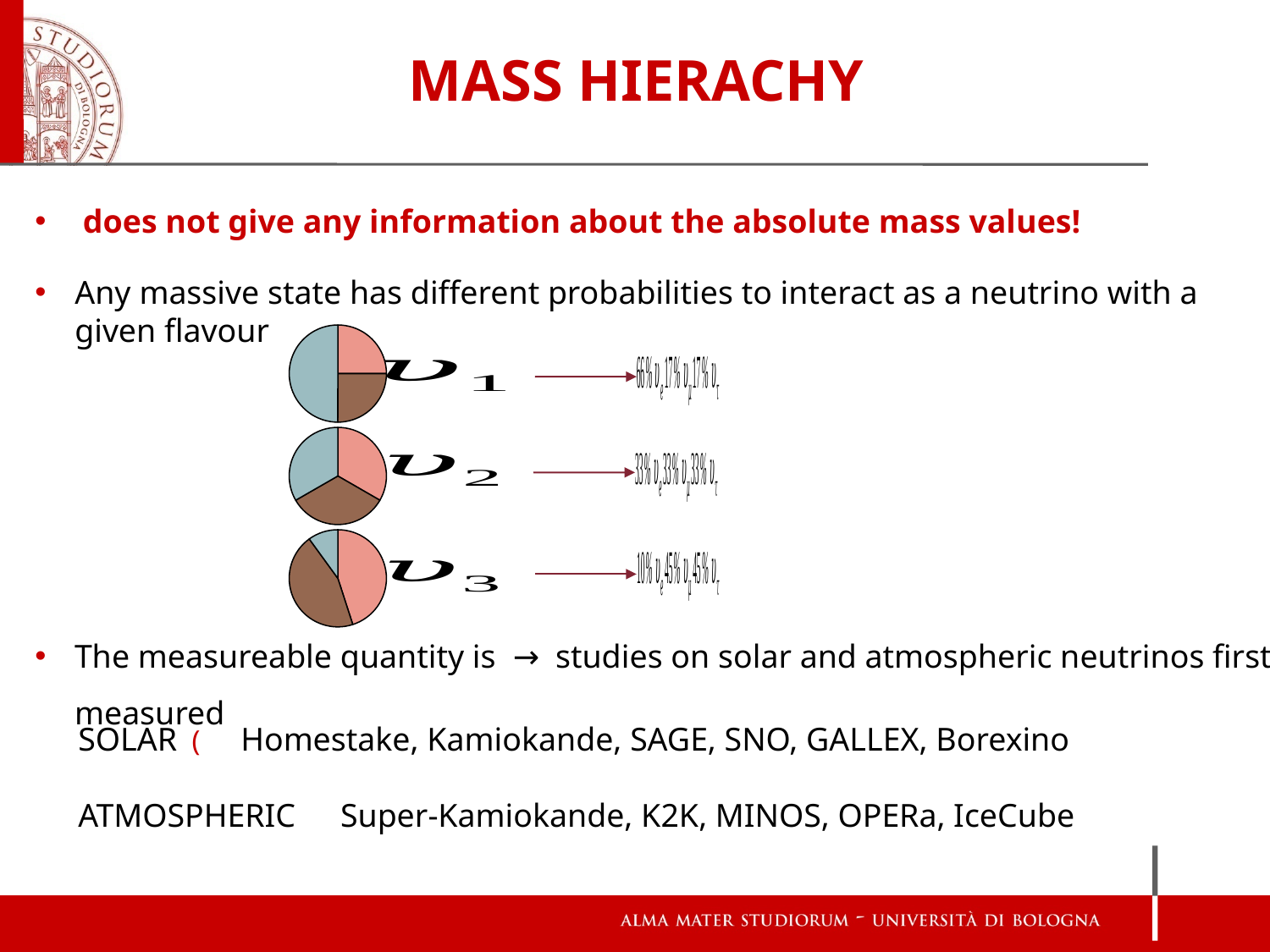
In the ν3 pie chart, which flavour has the smallest share? νe For the ν2 pie chart, what percentage is given for νe? 33% What is the difference between the νe share in the ν1 pie chart and the νe share in the ν3 pie chart? 56% For the ν1 pie chart, what percentage is given for νμ? 17% What kind of charts are shown next to the labels ν1, ν2 and ν3? Pie charts How many pie charts are shown on the slide? 3 How many slices does each pie chart have? 3 For the ν1 pie chart, what percentage is given for νe? 66% For the ν3 pie chart, what percentage is given for νe? 10% Which is larger: the νe share in the ν1 pie chart or the νe share in the ν3 pie chart? ν1 For the ν3 pie chart, what percentage is given for νμ? 45% In the ν1 pie chart, which flavour has the largest share? νe